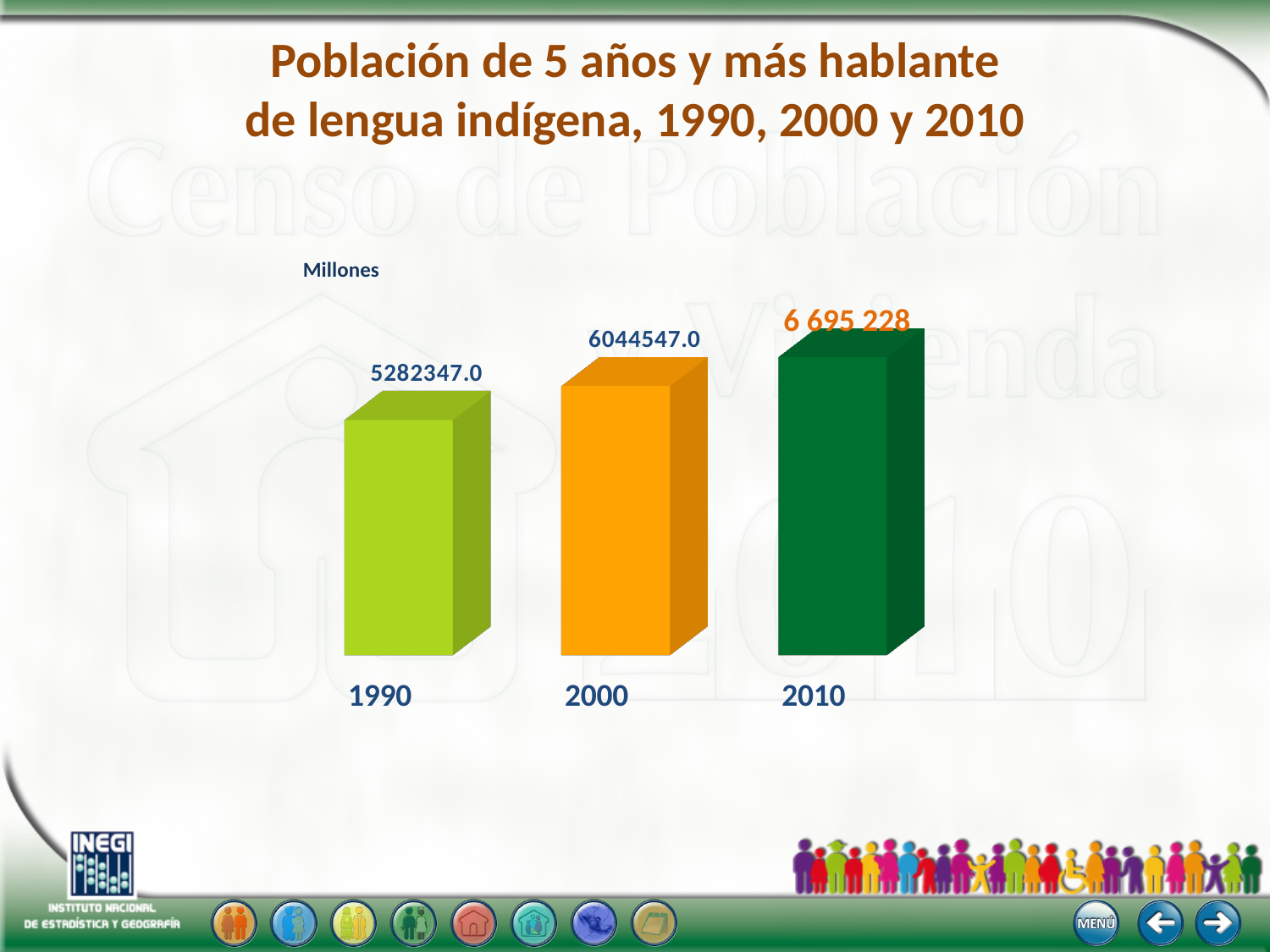
Which year has the lowest value? 1990 What colour is the bar for 2000? Orange Which is larger, the value for 2000 or the value for 1990? 2000 What is the value shown for 2010? 6 695 228 What kind of chart is shown on the slide? Bar chart Which year has the highest value? 2010 What is the value shown for 1990? 5282347.0 What is the difference between the values for 2000 and 1990? 762200.0 What unit label is shown above the chart? Millones Do the values rise or fall from 1990 to 2010? Rise How many bars are plotted in the chart? 3 What is the value shown for 2000? 6044547.0